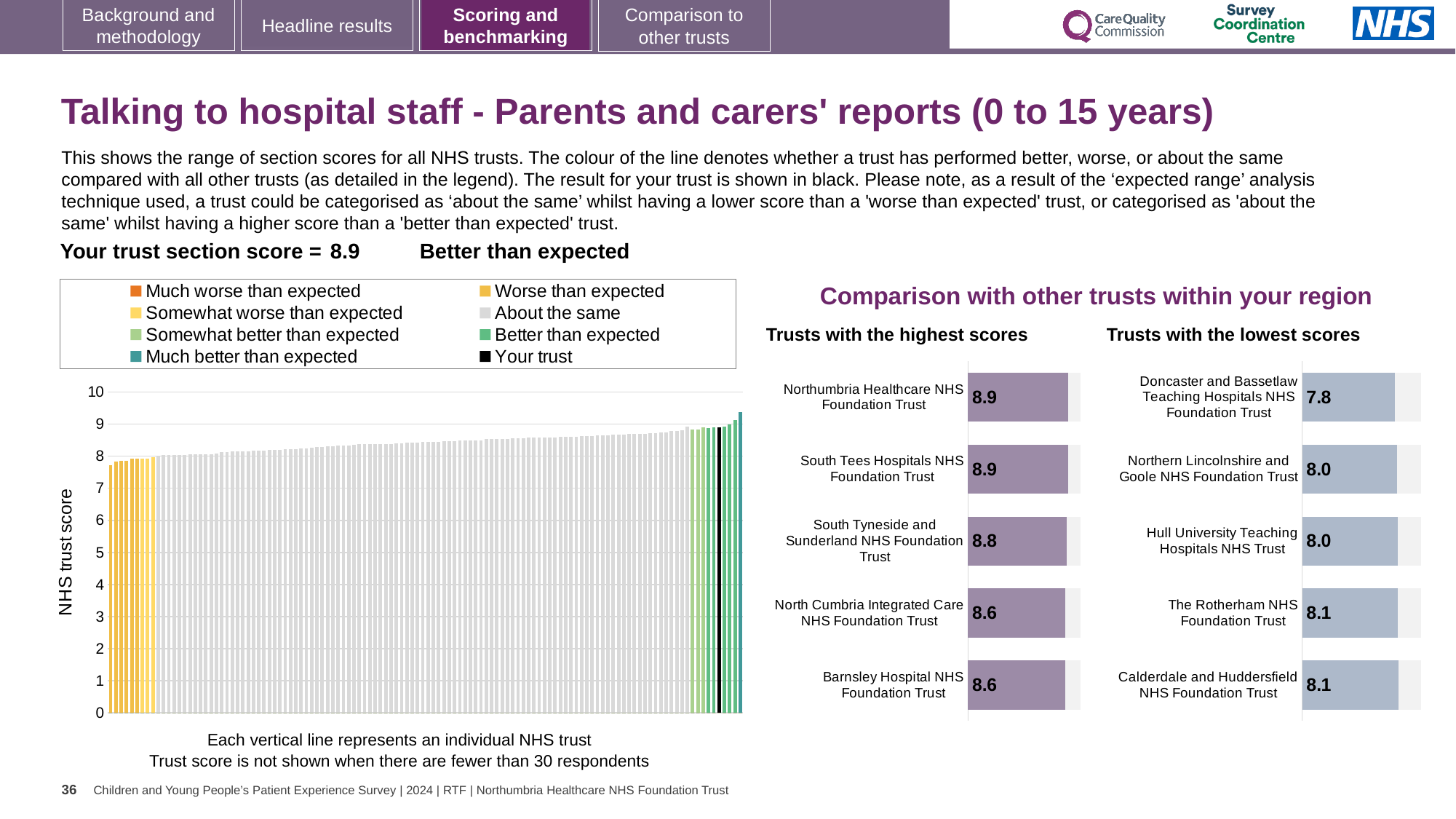
In the 'Trusts with the highest scores' chart, what is the score for North Cumbria Integrated Care NHS Foundation Trust? 8.6 In the 'Trusts with the lowest scores' chart, which trust has the lowest score? Doncaster and Bassetlaw Teaching Hospitals NHS Foundation Trust In the large chart on the left showing the range of section scores, is the value for the black 'Your trust' bar greater or less than 8? greater What kind of chart is the large chart on the left showing the range of section scores for all NHS trusts? bar chart How many entries does the legend above the large chart on the left list? 8 In the 'Trusts with the highest scores' chart, what is the score for South Tyneside and Sunderland NHS Foundation Trust? 8.8 How many trusts are shown in the 'Trusts with the highest scores' chart? 5 In the 'Trusts with the lowest scores' chart, what is the difference between the score for Calderdale and Huddersfield NHS Foundation Trust and the score for Doncaster and Bassetlaw Teaching Hospitals NHS Foundation Trust? 0.3 In the 'Trusts with the lowest scores' chart, which has the larger score: The Rotherham NHS Foundation Trust or Doncaster and Bassetlaw Teaching Hospitals NHS Foundation Trust? The Rotherham NHS Foundation Trust In the 'Trusts with the lowest scores' chart, what is the score for Doncaster and Bassetlaw Teaching Hospitals NHS Foundation Trust? 7.8 In the 'Trusts with the highest scores' chart, what is the difference between the score for Northumbria Healthcare NHS Foundation Trust and the score for Barnsley Hospital NHS Foundation Trust? 0.3 How many trusts are shown in the 'Trusts with the lowest scores' chart? 5